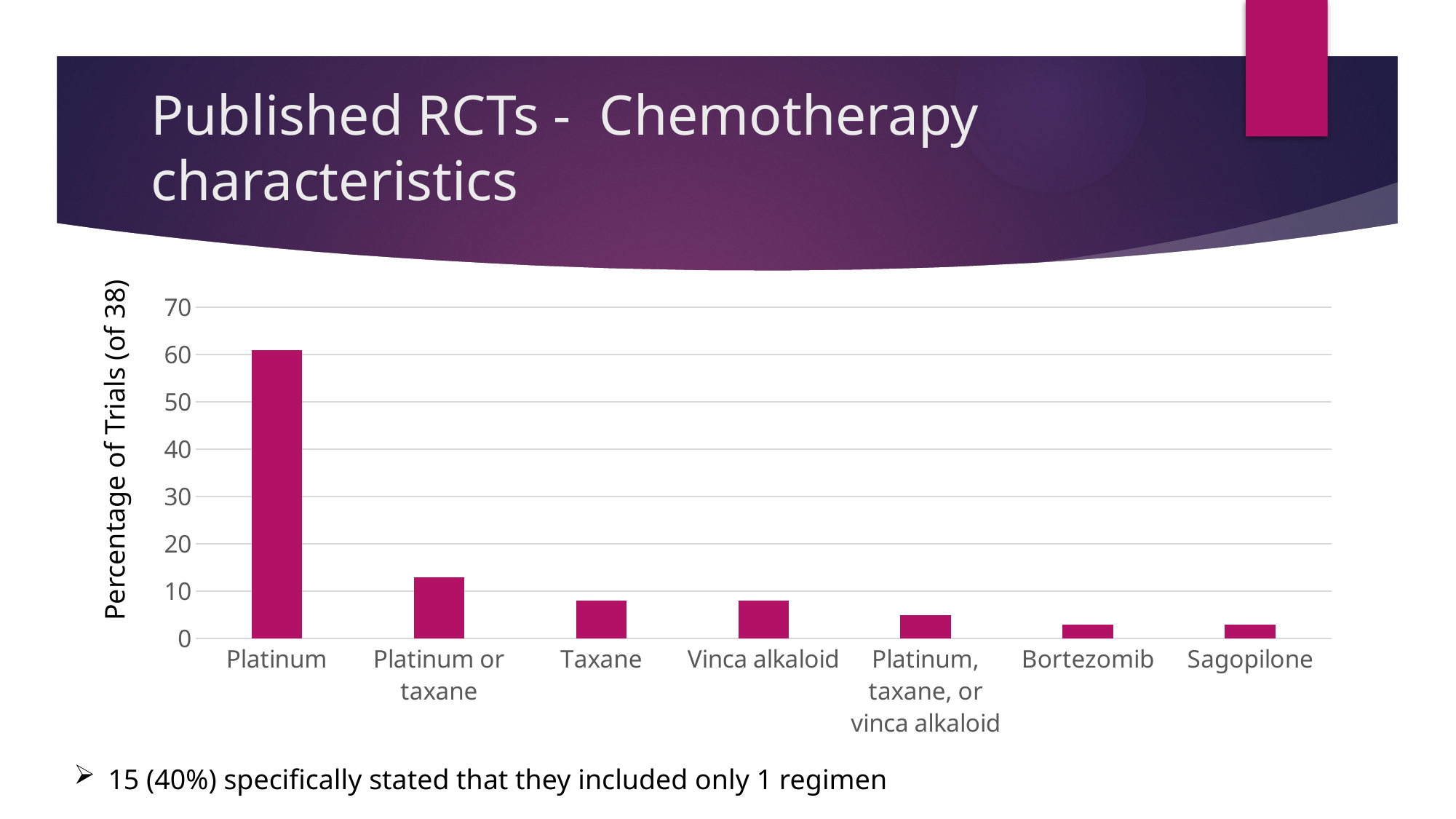
How many chemotherapy categories are shown on the x axis? 7 What kind of chart is shown on the slide? bar chart Is the value for Bortezomib greater or less than 10? less Which is larger, the value for Platinum or taxane or the value for Sagopilone? Platinum or taxane Is the value for Platinum greater or less than 70? less Which is larger, the value for Platinum or the value for Taxane? Platinum Is the value for Platinum or taxane greater or less than 10? greater Do the values generally rise or fall moving from left to right along the x axis? fall What is the title of the y axis? Percentage of Trials (of 38) Which category has the highest percentage of trials? Platinum